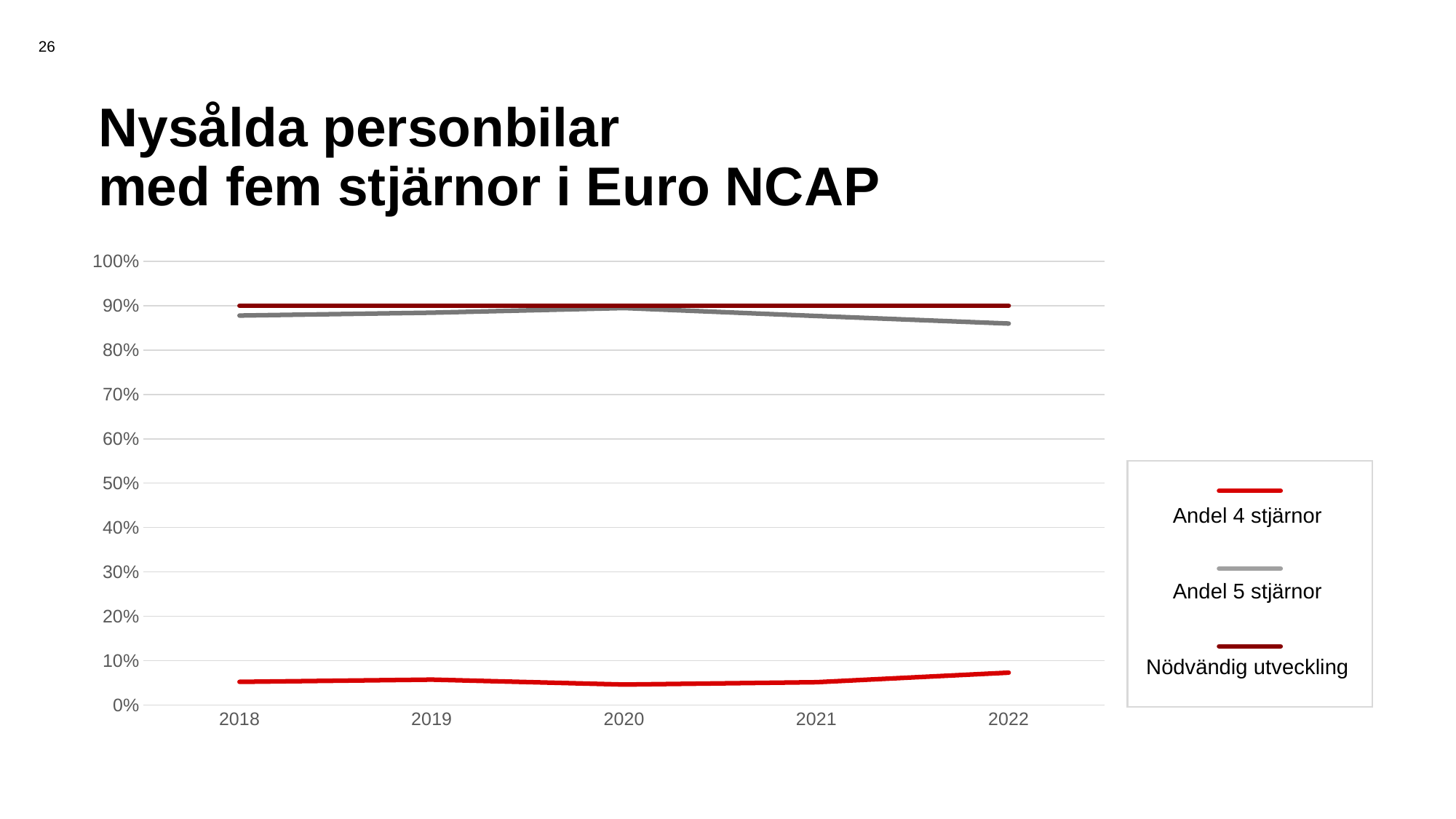
What is the value of the Nödvändig utveckling line in 2018? 90% Which is larger in 2020, Andel 5 stjärnor or Andel 4 stjärnor? Andel 5 stjärnor What is the value of the Nödvändig utveckling line in 2022? 90% What kind of chart is shown on the slide? line chart Does the Andel 5 stjärnor line rise or fall from 2020 to 2022? fall In which year is Andel 4 stjärnor at its highest? 2022 How many series does the legend list? 3 How many years are plotted along the x axis? 5 In which year is Andel 5 stjärnor at its lowest? 2022 Is the value for Andel 5 stjärnor in 2022 greater or less than 90%? less What colour is the Andel 5 stjärnor line in the legend? grey Is the value for Andel 4 stjärnor in 2022 greater or less than 10%? less